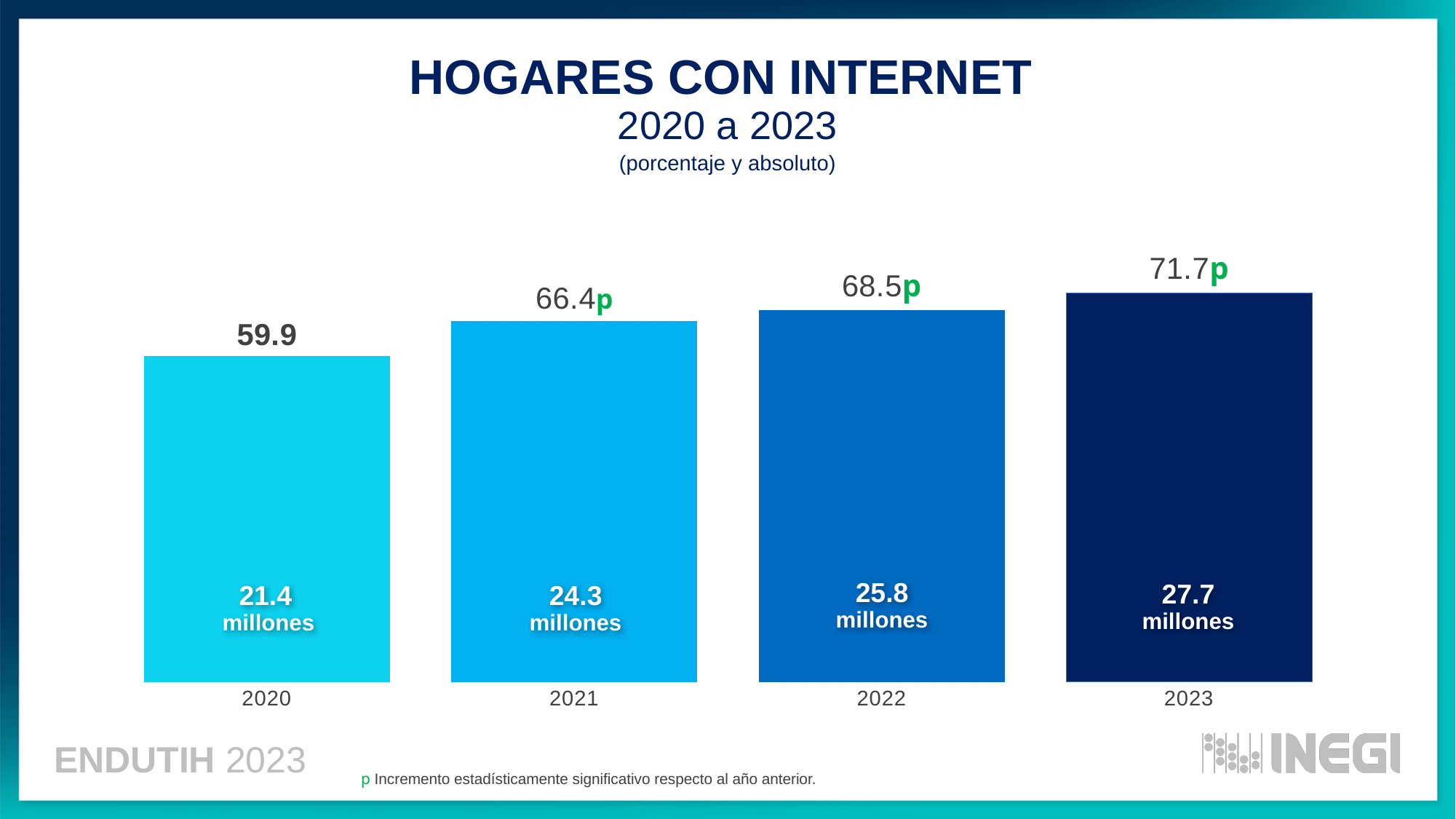
How many millions of households had internet in 2022? 25.8 millones What percentage of households had internet in 2020? 59.9 What percentage of households had internet in 2023? 71.7 Which year has a higher percentage, 2021 or 2022? 2022 Which year has the highest percentage of households with internet? 2023 Do the percentages rise or fall from 2020 to 2023? Rise How many years are shown in the chart? 4 What kind of chart is shown on the slide? Bar chart Which year has the lowest percentage of households with internet? 2020 What is the difference in millions of households between 2022 and 2021? 1.5 How many millions of households had internet in 2021? 24.3 millones What is the difference in percentage points between 2023 and 2020? 11.8